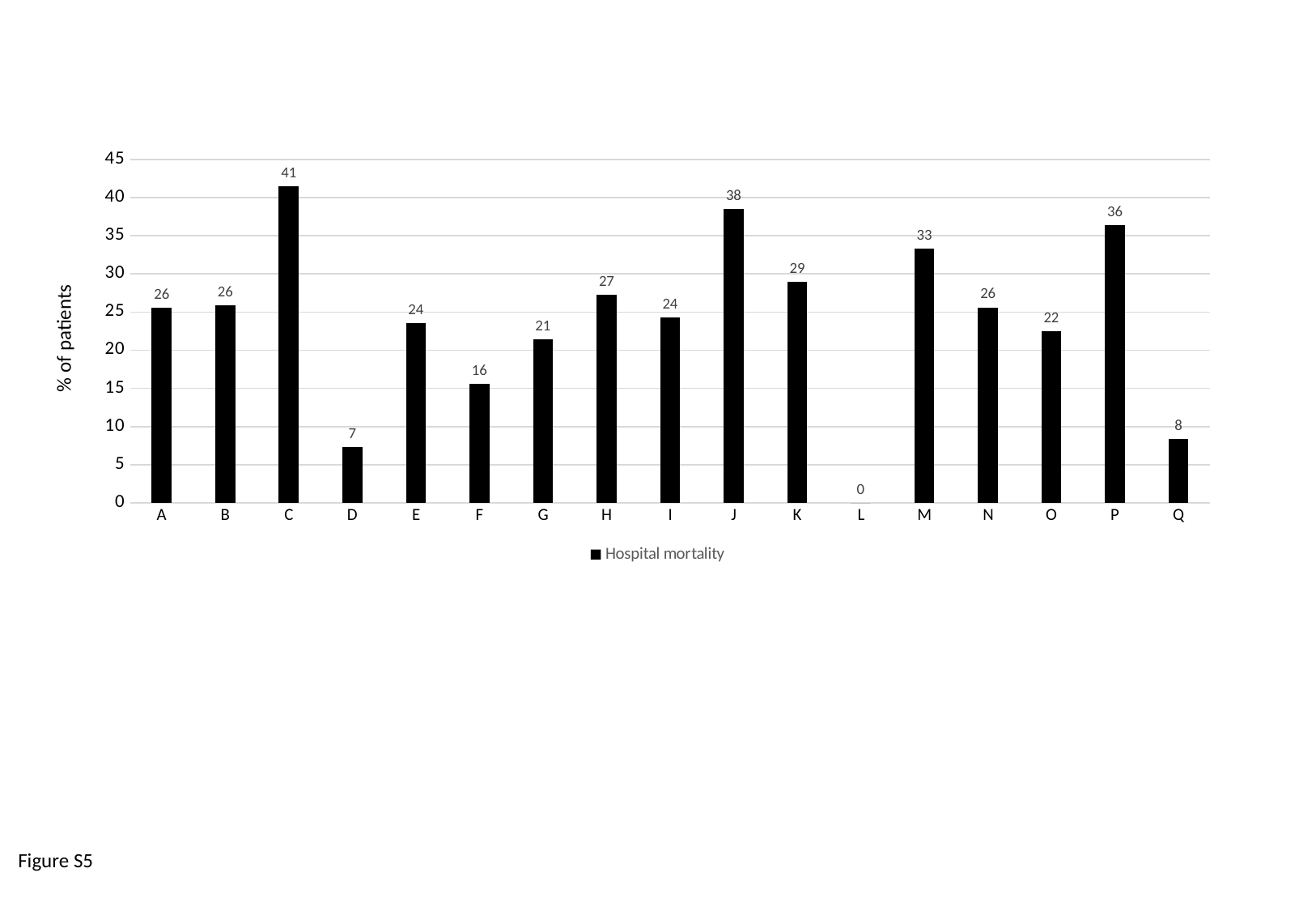
Is the value for P greater or less than 30? greater Which category has the lowest hospital mortality? L What kind of chart is shown on the slide? Bar chart What is the hospital mortality value for category C? 41 What is the difference between the hospital mortality values for C and Q? 33 How many series does the legend list? 1 What is the label of the y axis? % of patients How many categories are shown on the x axis? 17 What is the hospital mortality value for category D? 7 Which category has the highest hospital mortality? C Which has a higher hospital mortality value, K or M? M What is the hospital mortality value for category J? 38